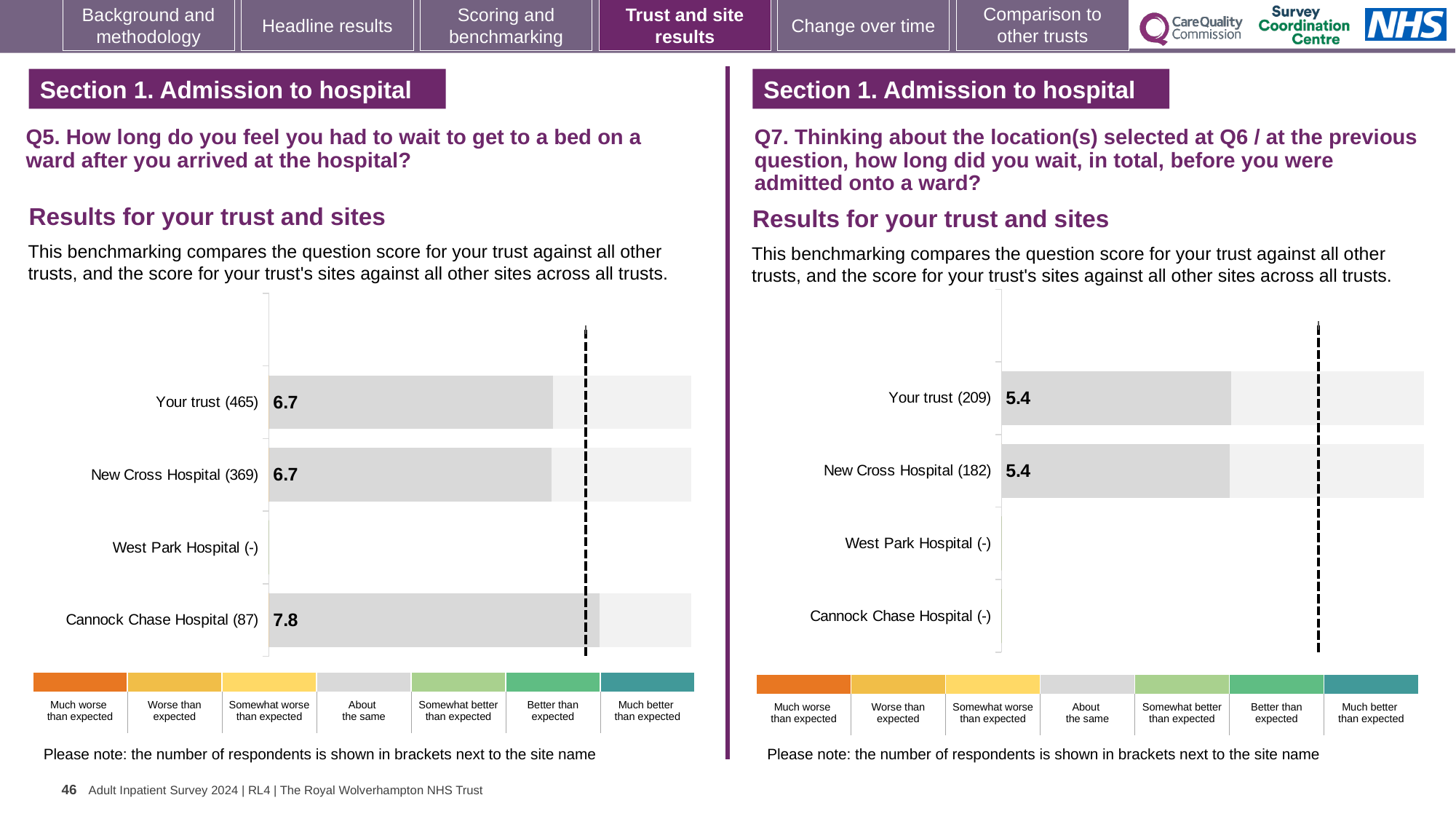
On the Q7 chart (right), what is the score for Your trust? 5.4 On the Q7 chart (right), what is the score for New Cross Hospital? 5.4 On the Q5 chart (left), what is the score for Your trust? 6.7 On the Q7 chart (right), how many rows (trust and sites) are listed on the vertical axis? 4 On the Q5 chart (left), what is the score for Cannock Chase Hospital? 7.8 On the Q5 chart (left), how many respondents are shown for Your trust? 465 On the Q5 chart (left), what is the score for New Cross Hospital? 6.7 On the Q5 chart (left), which site has the highest score? Cannock Chase Hospital What kind of chart is used on the Q5 chart (left)? Bar chart On the Q5 chart (left), how many categories does the colour key below the chart list? 7 On the Q7 chart (right), how many respondents are shown for New Cross Hospital? 182 On the Q5 chart (left), what is the difference between the scores for Cannock Chase Hospital and New Cross Hospital? 1.1